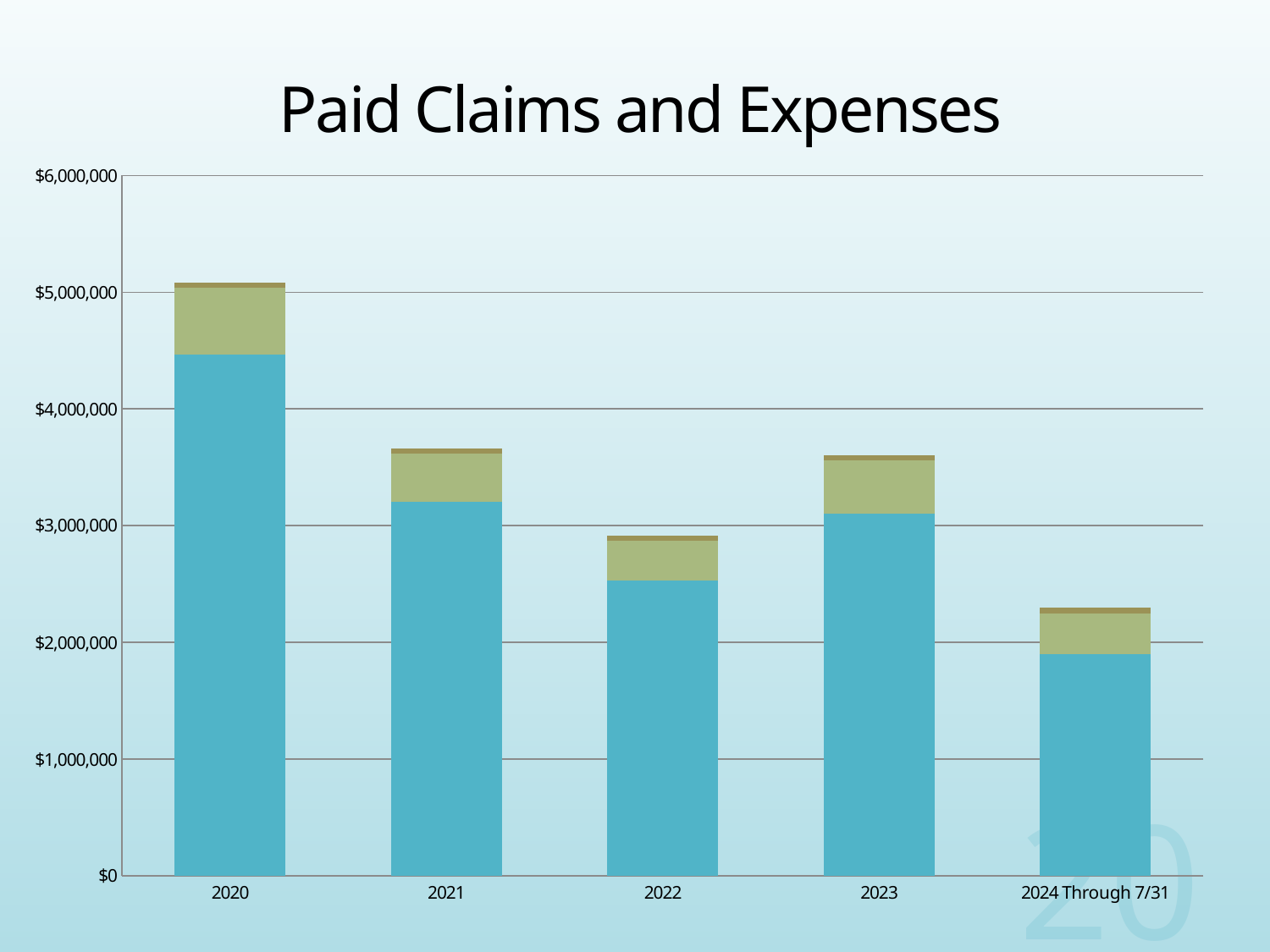
How many categories are shown on the x axis? 5 Is the total bar height for 2022 greater or less than $3,000,000? less Is the total bar height for 2024 Through 7/31 greater or less than $2,000,000? greater Which category has the tallest bar? 2020 What is the title of the chart? Paid Claims and Expenses Is the total bar height for 2021 greater or less than $4,000,000? less Do the bar totals rise or fall from 2020 to 2022? fall What kind of chart is shown on the slide? stacked bar chart Which category has the shortest bar? 2024 Through 7/31 Which has the taller bar, 2021 or 2022? 2021